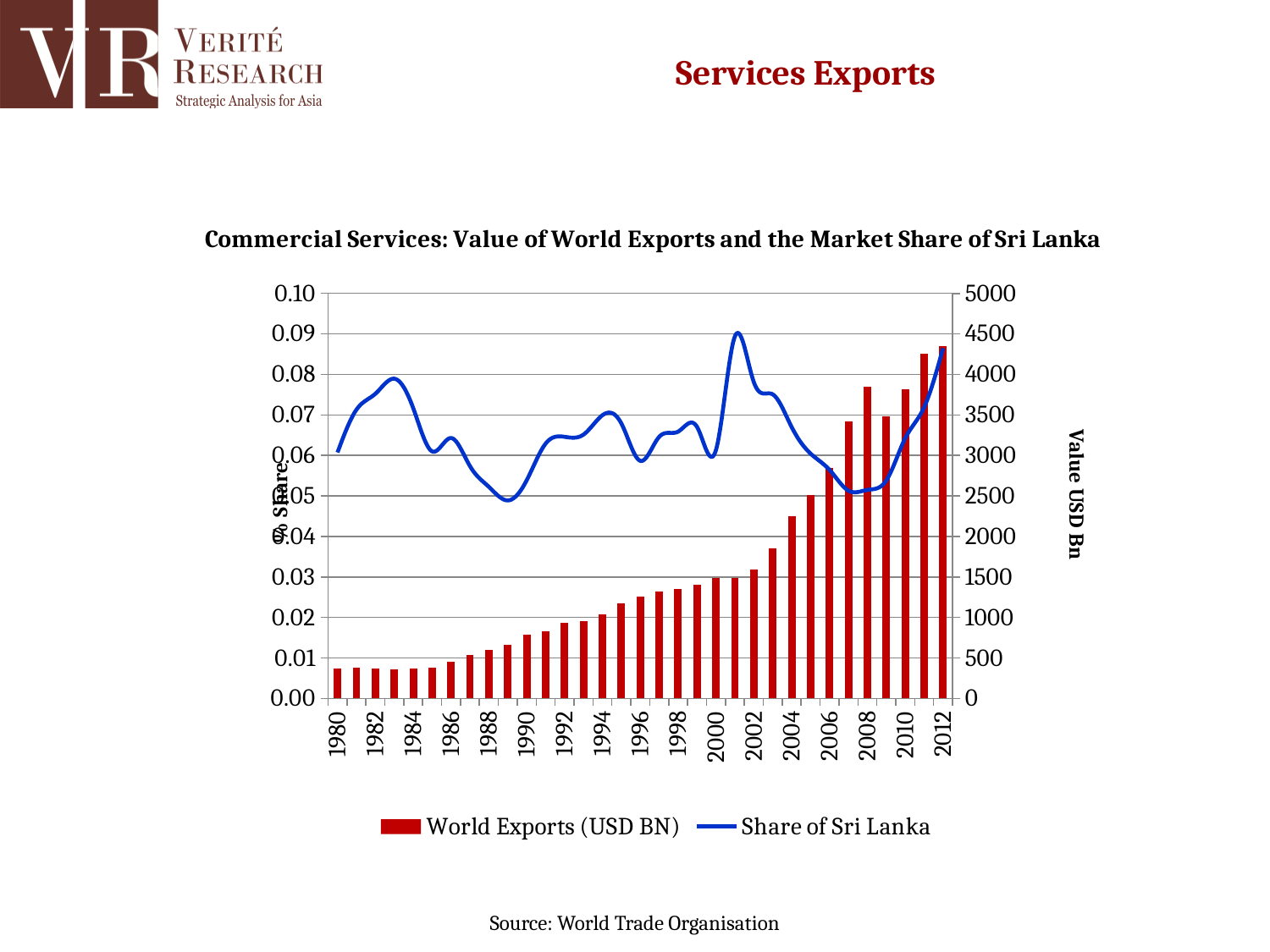
Which year has the larger value for World Exports (USD BN), 2008 or 2009? 2008 What kind of chart is shown on the slide? A bar chart combined with a line chart Do the World Exports (USD BN) bars generally rise or fall from 1980 to 2012? Rise How many years (bars) are plotted for World Exports (USD BN)? 33 What is the title of the chart? Commercial Services: Value of World Exports and the Market Share of Sri Lanka Is the value for World Exports (USD BN) in 2012 greater or less than 4000? greater Is the Share of Sri Lanka in 2001 greater or less than 0.08? greater Is the Share of Sri Lanka in 2007 greater or less than 0.06? less How many series does the legend list? 2 In which year does the Share of Sri Lanka line reach its highest point? 2001 Which year has the highest value for World Exports (USD BN)? 2012